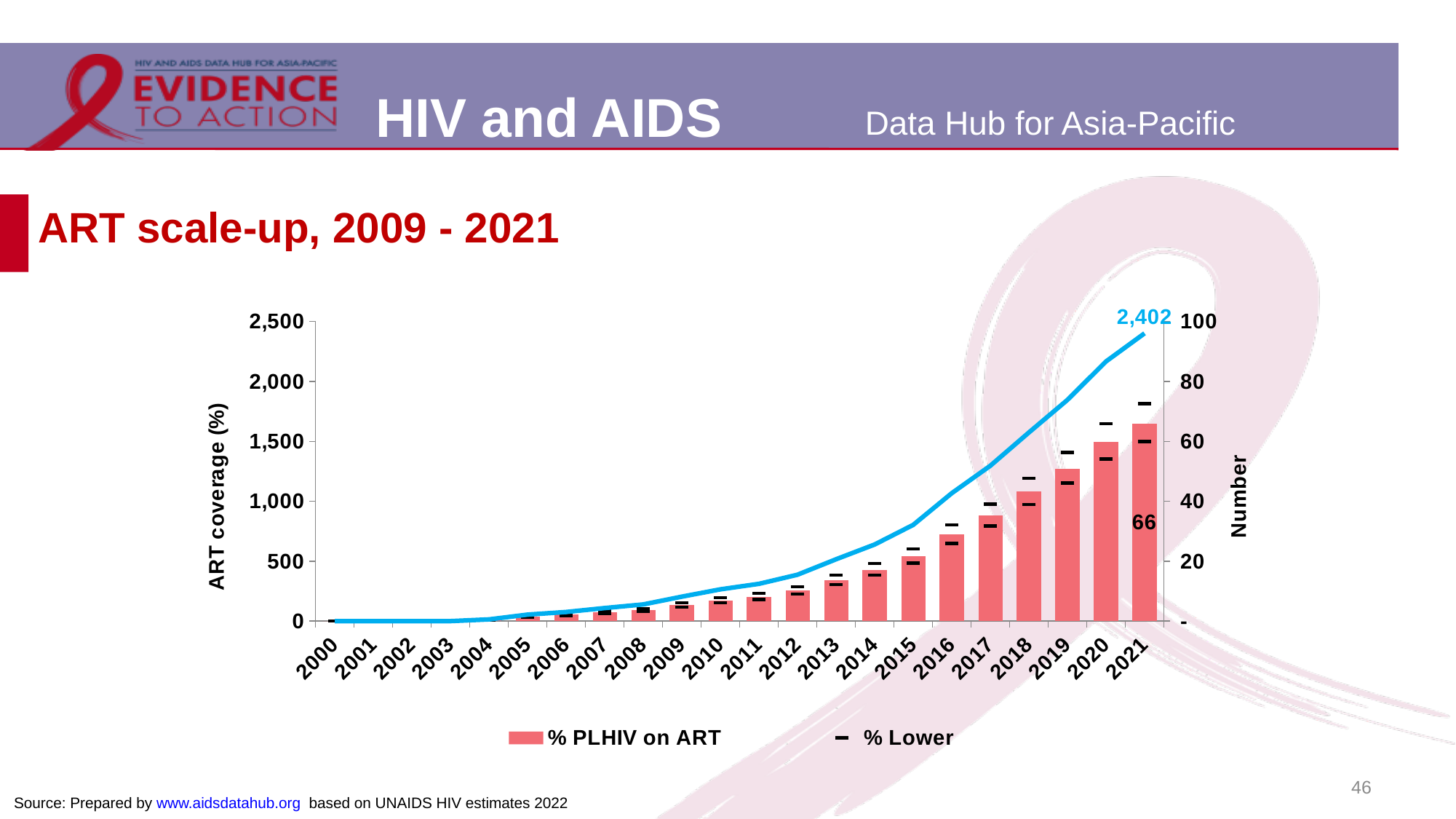
Is the % PLHIV on ART value for 2016 greater or less than 40 on the right axis? less Is the blue line value for 2020 greater or less than 2,000 on the left axis? greater Do the % PLHIV on ART bars rise or fall from 2000 to 2021? Rise How many years are shown on the x axis? 22 Which year has the highest % PLHIV on ART bar? 2021 What is the title of the chart? ART scale-up, 2009 - 2021 What is the value of % PLHIV on ART in 2021? 66 How many series does the legend list? 2 What value is labelled on the blue line in 2021? 2,402 Which year has the larger % PLHIV on ART bar, 2020 or 2021? 2021 What kind of chart is shown on the slide? Bar and line chart Which legend entry is shown with red bars? % PLHIV on ART